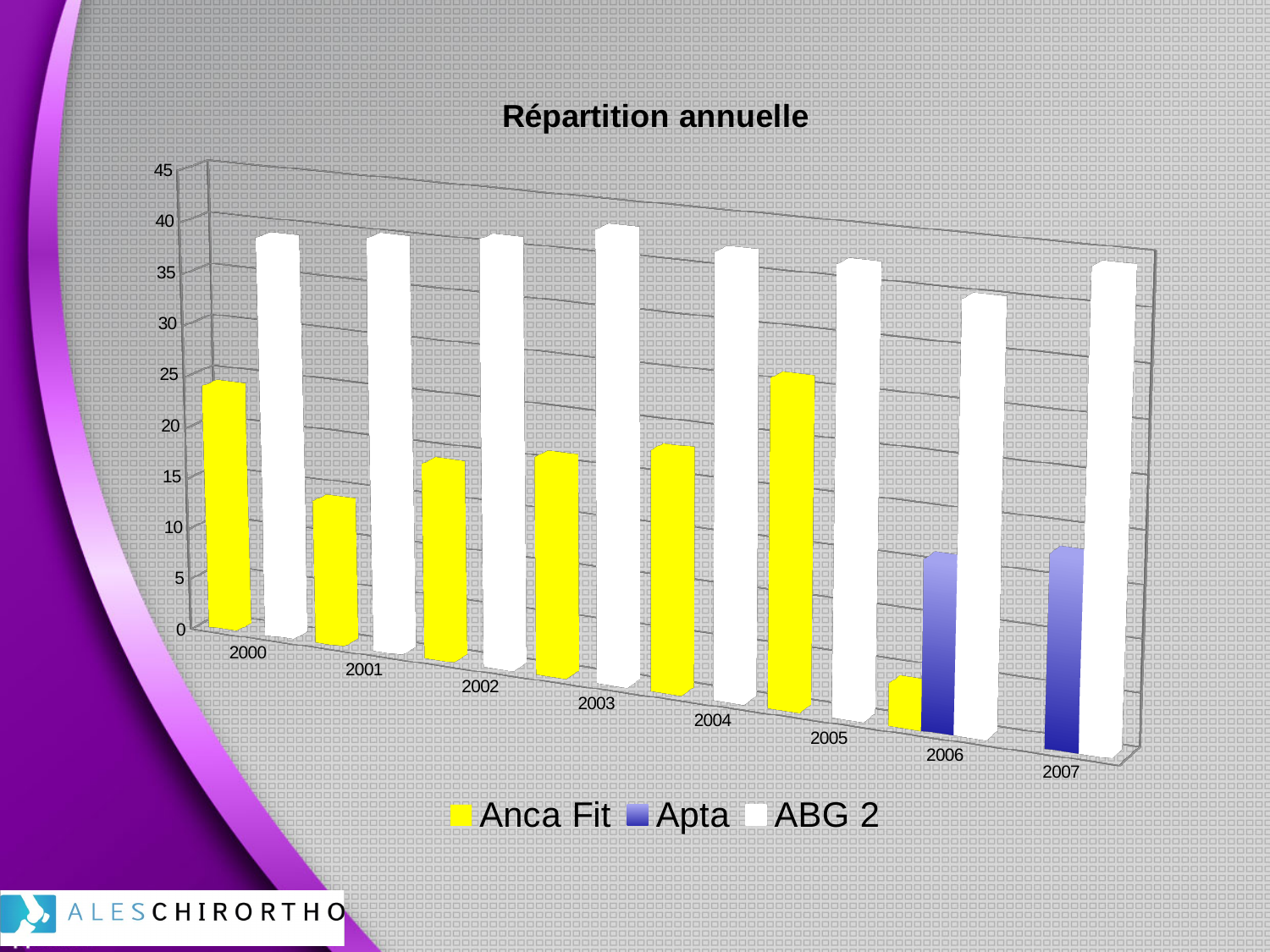
How many series does the legend list? 3 Which is larger in 2001, Anca Fit or ABG 2? ABG 2 Is the value for Anca Fit in 2001 greater or less than 15? less Is the value for ABG 2 in 2003 greater or less than 30? greater How many years are shown on the x axis? 8 What kind of chart is shown on the slide? bar chart What is the title of the chart? Répartition annuelle Is the value for Apta in 2007 greater or less than 10? greater In which year is the Anca Fit value lowest? 2006 Which series is shown in yellow? Anca Fit